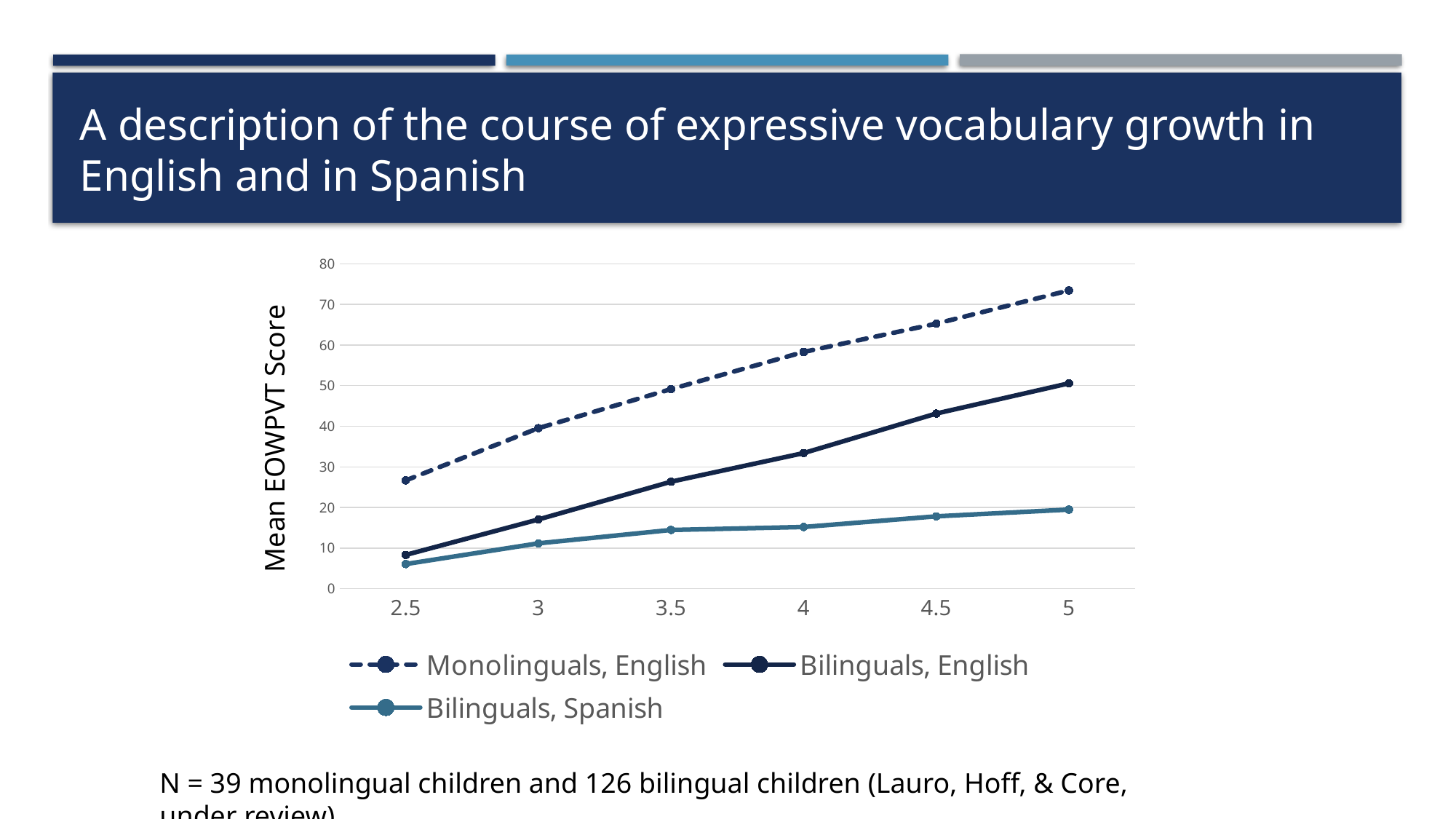
Is the value for Monolinguals, English at age 5 greater or less than 70? greater What kind of chart is shown on the slide? line chart Which series has the highest Mean EOWPVT Score at age 5? Monolinguals, English What is the label on the y axis of the chart? Mean EOWPVT Score Is the value for Monolinguals, English at age 3.5 greater or less than 40? greater At age 4, which is larger: the value for Bilinguals, English or the value for Bilinguals, Spanish? Bilinguals, English How many series does the legend list? 3 Does the Mean EOWPVT Score for Bilinguals, English rise or fall as age increases from 2.5 to 5? rise Is the value for Bilinguals, English at age 2.5 greater or less than 10? less How many age points are plotted along the x axis? 6 Which series has the lowest Mean EOWPVT Score at age 5? Bilinguals, Spanish